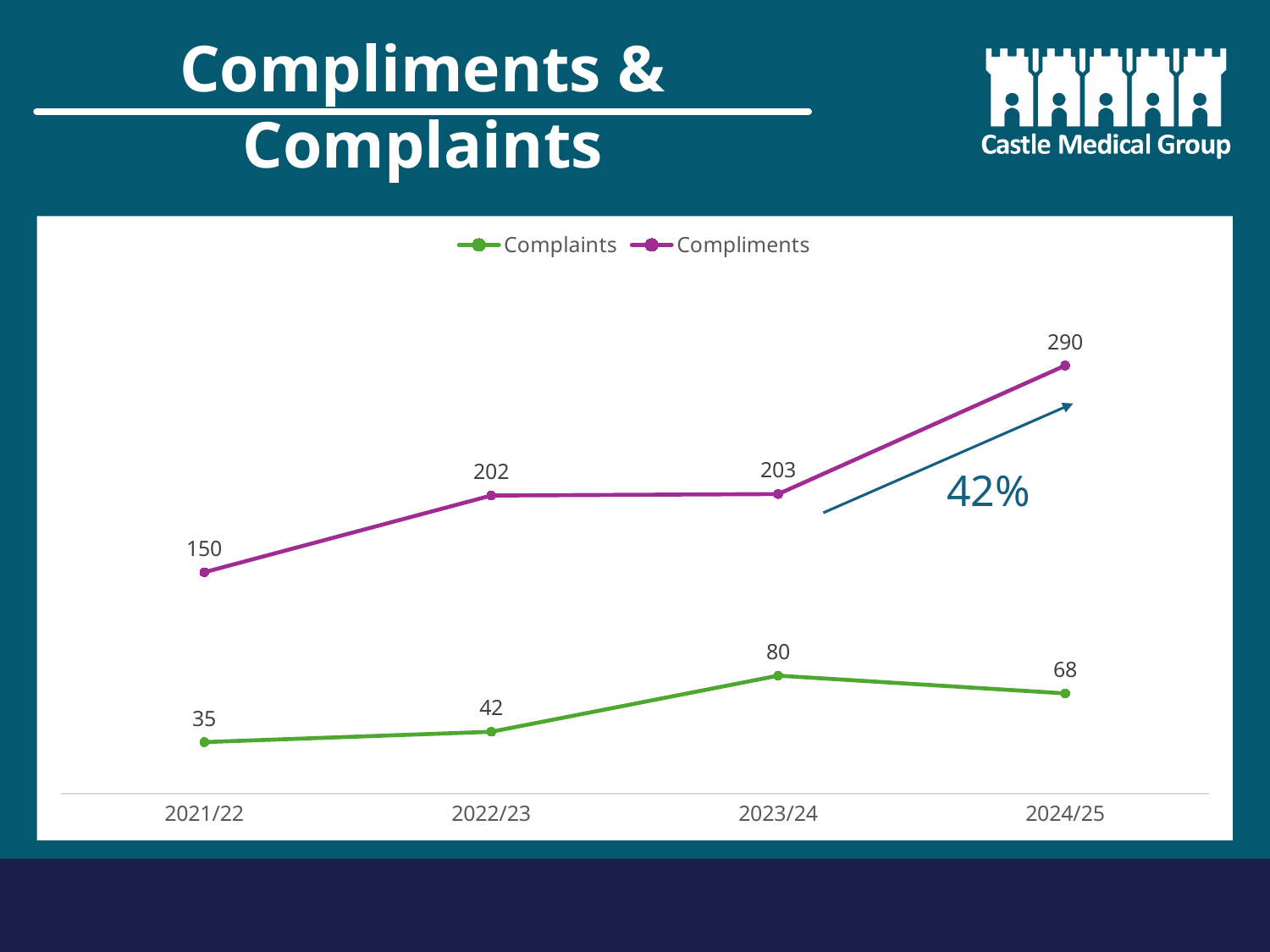
In which year were Compliments lowest? 2021/22 What is the number of Compliments in 2022/23? 202 What is the number of Complaints in 2021/22? 35 Do Compliments rise or fall from 2021/22 to 2024/25? Rise What is the number of Compliments in 2024/25? 290 How many series does the legend list? 2 What is the difference between Compliments in 2024/25 and 2023/24? 87 What is the number of Complaints in 2023/24? 80 What kind of chart is shown on the slide? Line chart Which is larger: Complaints in 2023/24 or Complaints in 2024/25? Complaints in 2023/24 In which year were Complaints highest? 2023/24 How many years are shown on the x axis? 4